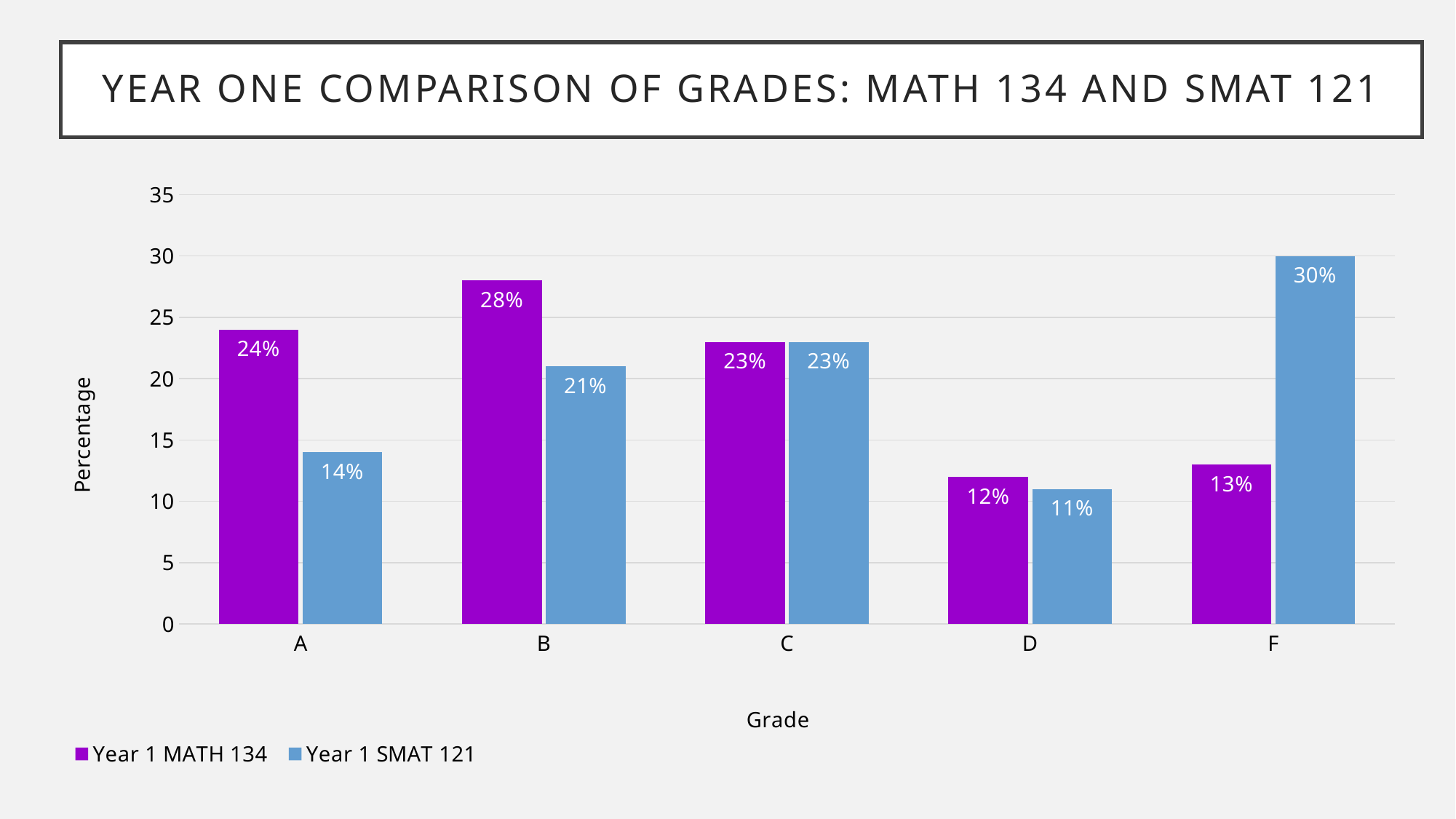
What is the Year 1 SMAT 121 percentage for grade F? 30% What kind of chart is shown on the slide? Bar chart Is the Year 1 MATH 134 value for grade B greater or less than 25? greater What is the Year 1 SMAT 121 percentage for grade B? 21% For grade F, which series has the larger percentage, Year 1 MATH 134 or Year 1 SMAT 121? Year 1 SMAT 121 Which grade has the highest Year 1 MATH 134 percentage? B Which grade has the lowest Year 1 SMAT 121 percentage? D What is the title of the chart? YEAR ONE COMPARISON OF GRADES: MATH 134 AND SMAT 121 How many grade categories are shown on the x axis? 5 What is the difference between the Year 1 MATH 134 and Year 1 SMAT 121 percentages for grade A? 10% What is the Year 1 MATH 134 percentage for grade A? 24% How many series does the legend list? 2